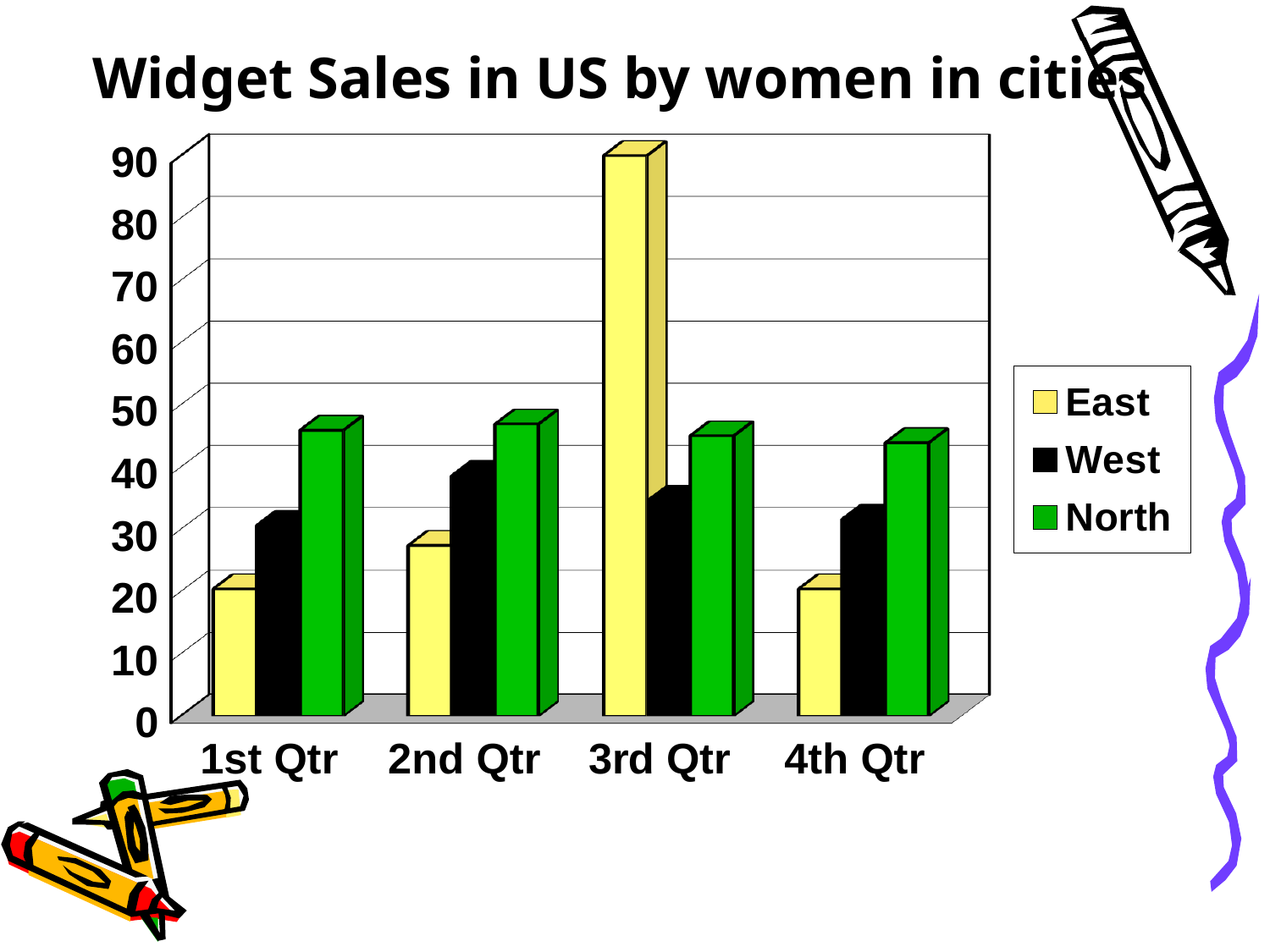
Is the value for North in 1st Qtr greater or less than 50? less In 3rd Qtr, which is larger, East or North? East How many quarters are shown on the x axis? 4 In which quarter is the East series highest? 3rd Qtr What kind of chart is shown on the slide? bar chart How many series does the legend list? 3 In 1st Qtr, which is larger, East or West? West Is the value for East in 3rd Qtr greater or less than 80? greater Is the value for East in 1st Qtr greater or less than 30? less What is the title of the chart? Widget Sales in US by women in cities Which series is shown in green in the legend? North In which quarter is the West series highest? 2nd Qtr